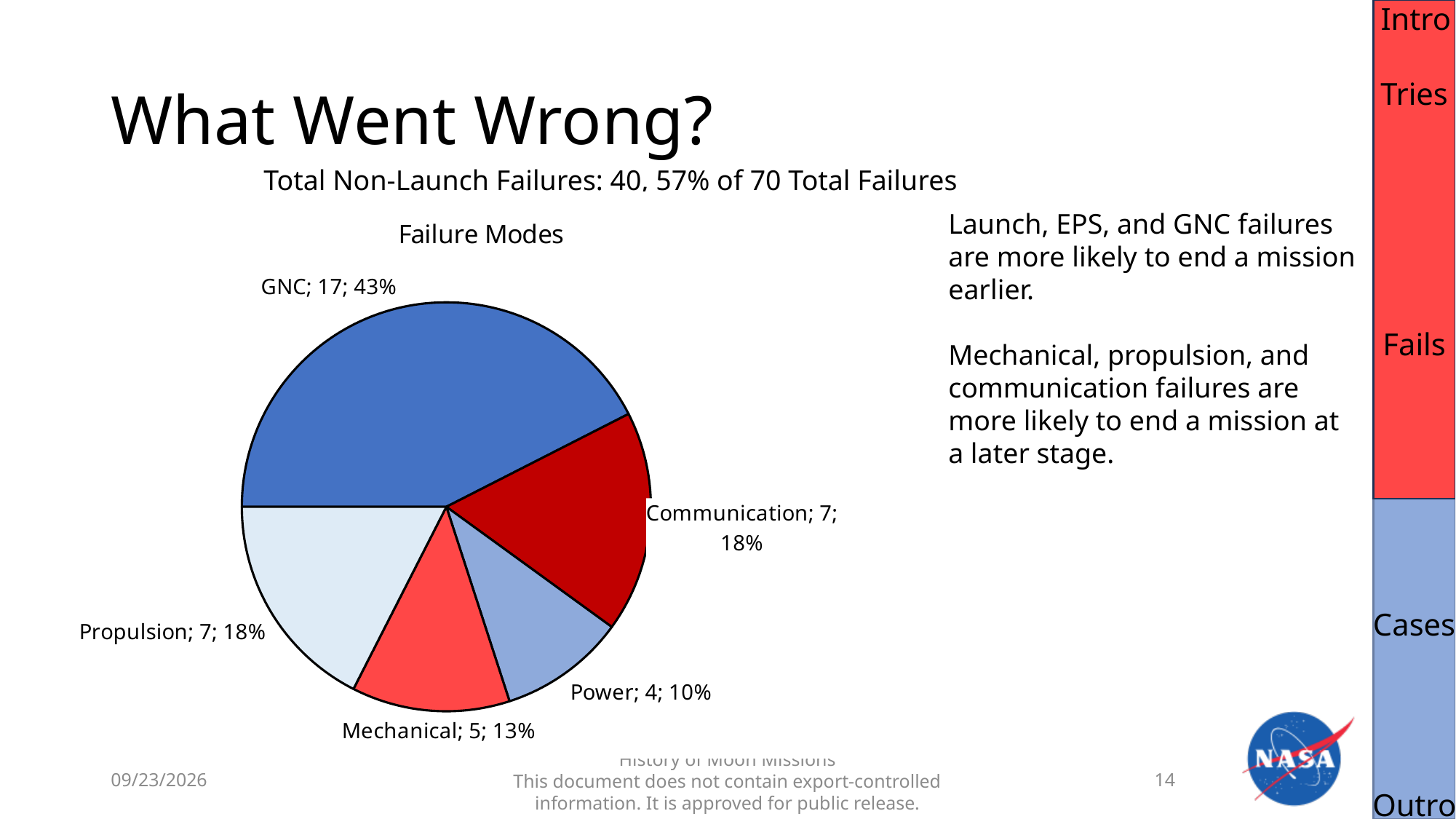
What share of the pie does GNC represent? 43% Which failure mode has the smallest slice? Power How many slices does the pie chart have? 5 What kind of chart is shown on the slide? pie chart What is the difference between the GNC count and the Communication count? 10 What share of the pie does Mechanical represent? 13% Which failure mode has the largest slice? GNC How many failures are attributed to Power? 4 Which has more failures, Mechanical or Power? Mechanical What share of the pie does Communication represent? 18% What is the title of the chart? Failure Modes How many failures are attributed to GNC? 17